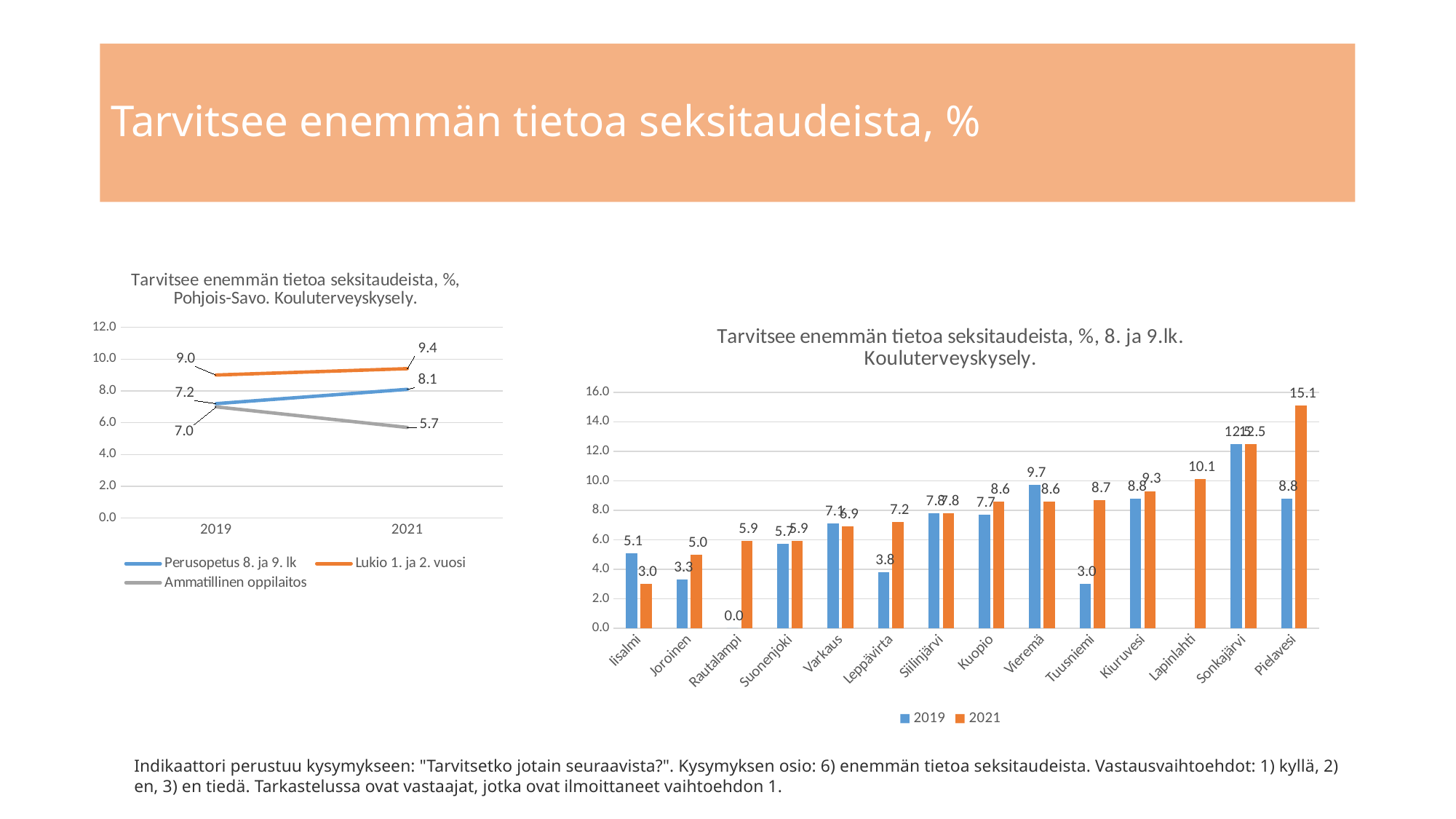
What kind of chart is the right chart titled "Tarvitsee enemmän tietoa seksitaudeista, %, 8. ja 9.lk. Kouluterveyskysely."? bar chart In the right chart (8. ja 9.lk by municipality), what is the 2021 value for Pielavesi? 15.1 In the left chart (Pohjois-Savo), what is the difference between Lukio 1. ja 2. vuosi and Perusopetus 8. ja 9. lk in 2019? 1.8 What kind of chart is the left chart titled "Tarvitsee enemmän tietoa seksitaudeista, %, Pohjois-Savo. Kouluterveyskysely."? line chart How many municipalities are shown on the x axis of the right chart (8. ja 9.lk)? 14 In the left chart (Pohjois-Savo), does the Ammatillinen oppilaitos line rise or fall from 2019 to 2021? fall In the right chart (8. ja 9.lk by municipality), what is the difference between the 2021 and 2019 values for Tuusniemi? 5.7 In the left chart (Pohjois-Savo), what is the value for Ammatillinen oppilaitos in 2019? 7.0 In the right chart (8. ja 9.lk by municipality), which municipality has the highest 2021 value? Pielavesi In the right chart (8. ja 9.lk by municipality), is the 2019 or the 2021 value larger for Vieremä? 2019 How many series does the legend of the left chart (Pohjois-Savo) list? 3 In the left chart (Pohjois-Savo), what is the value for Lukio 1. ja 2. vuosi in 2021? 9.4